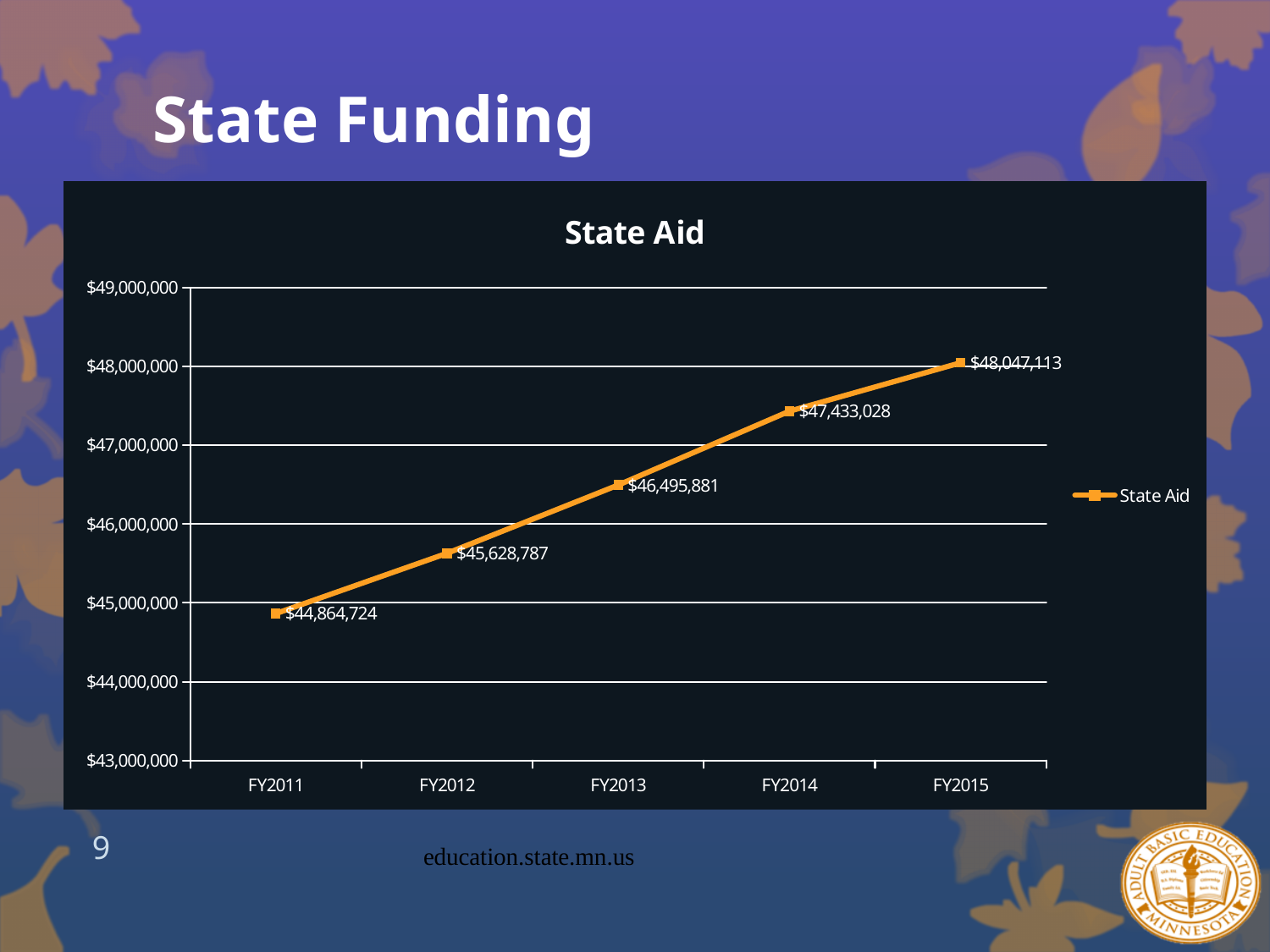
What is the State Aid value for FY2015? $48,047,113 What is the difference in State Aid between FY2014 and FY2013? $937,147 Do the State Aid values rise or fall from FY2011 to FY2015? rise How many fiscal years are plotted on the State Aid chart? 5 Which is larger, the State Aid value for FY2012 or for FY2014? FY2014 What is the State Aid value for FY2013? $46,495,881 Is the State Aid value for FY2014 greater or less than $47,000,000? greater What is the difference in State Aid between FY2015 and FY2011? $3,182,389 What kind of chart is the State Aid chart? line chart What is the State Aid value for FY2011? $44,864,724 Which fiscal year has the lowest State Aid value? FY2011 Which fiscal year has the highest State Aid value? FY2015